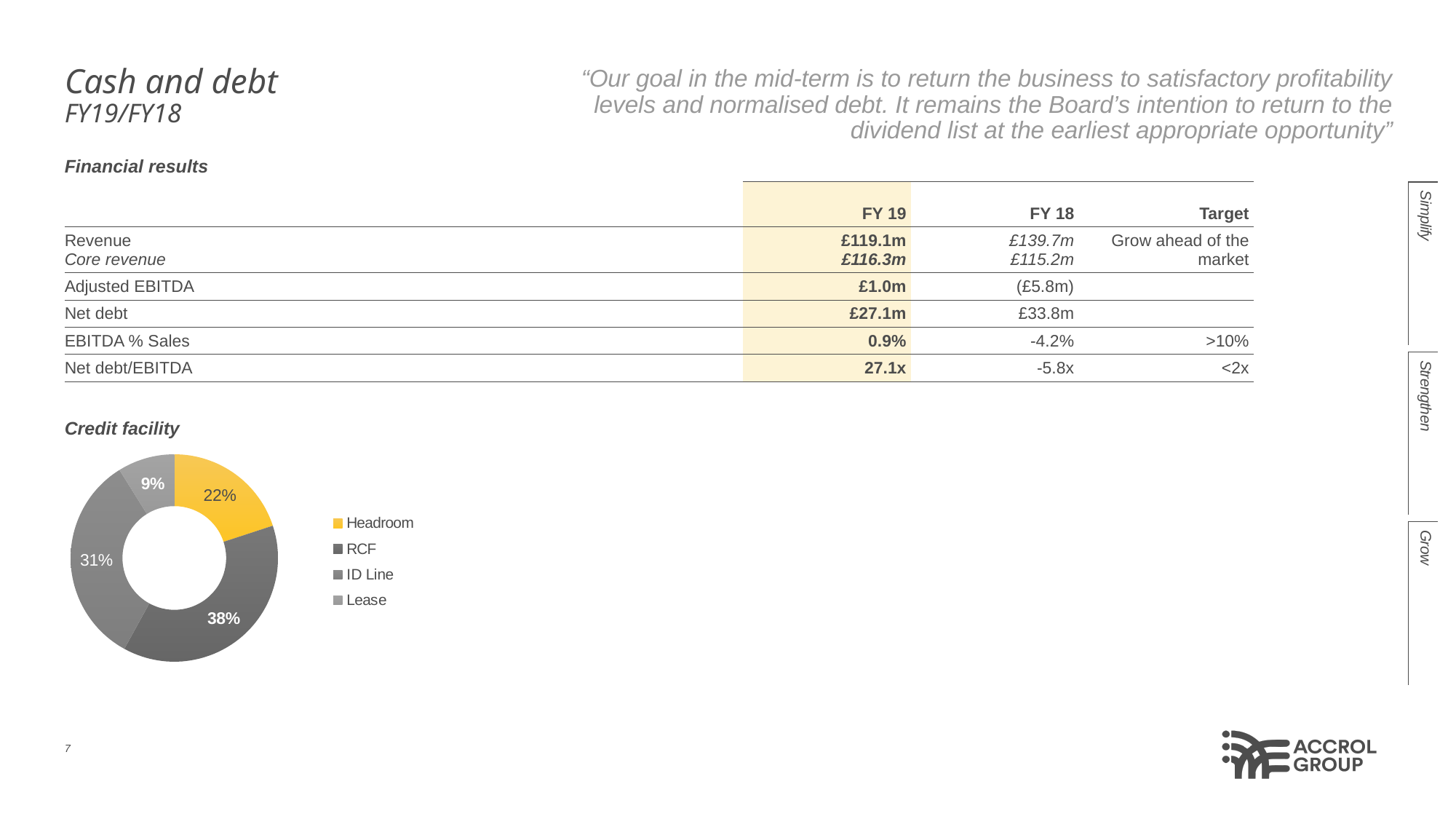
In the Credit facility chart, what is the combined share of RCF and ID Line? 69% In the Credit facility chart, what share does ID Line represent? 31% Which category has the smallest share in the Credit facility chart? Lease In the Credit facility chart, what colour is the Headroom slice? Yellow How many categories does the Credit facility chart show? 4 In the Credit facility chart, what share does Lease represent? 9% In the Credit facility chart, what share does RCF represent? 38% In the Credit facility chart, what share does Headroom represent? 22% In the Credit facility chart, what is the difference in percentage points between RCF and ID Line? 7 percentage points In the Credit facility chart, which is larger: Headroom or ID Line? ID Line Which category has the largest share in the Credit facility chart? RCF What kind of chart is shown under "Credit facility"? Doughnut (pie) chart